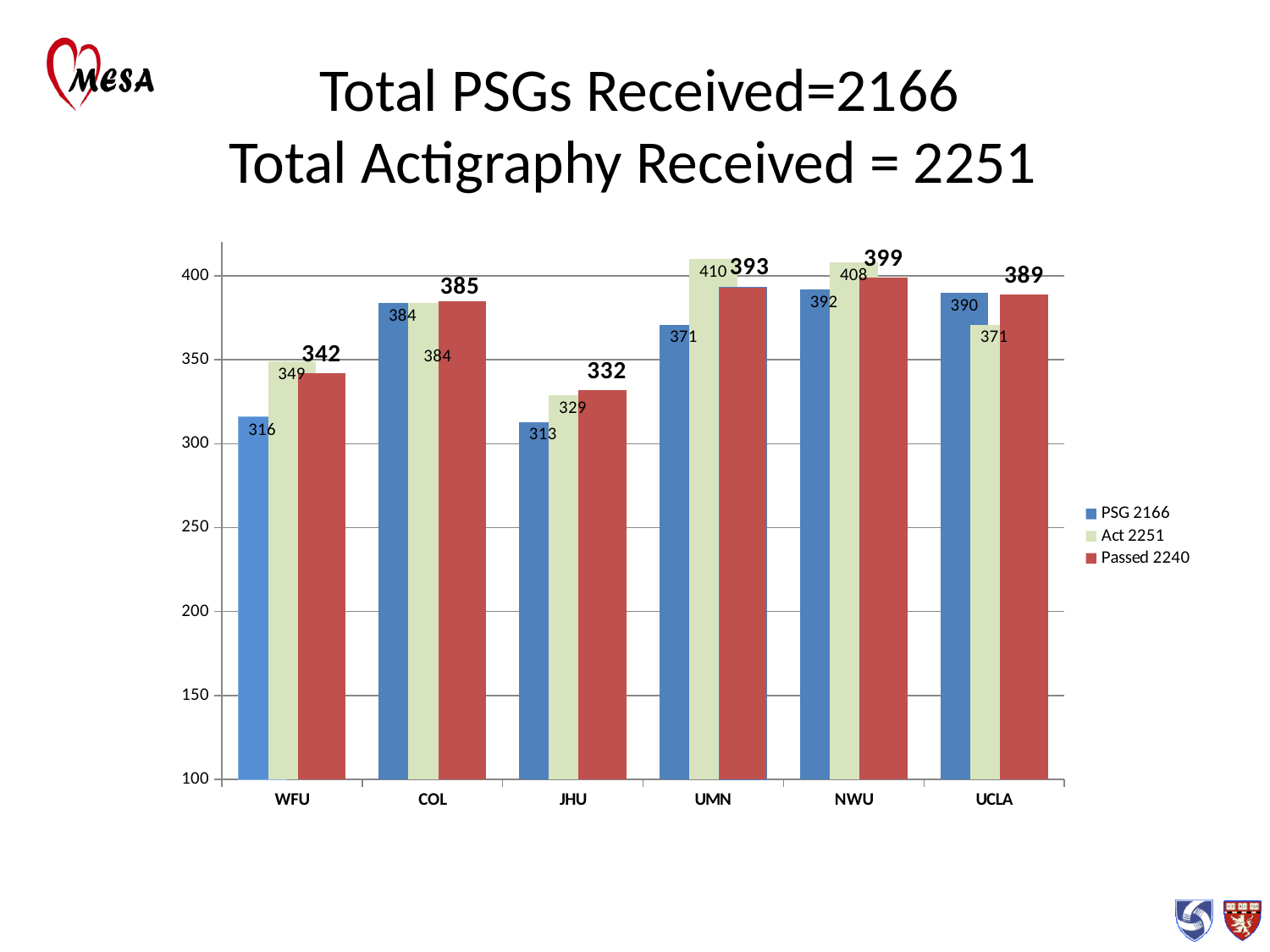
Which site has the highest Passed 2240 value? NWU What is the Passed 2240 value for JHU? 332 What is the Act 2251 value for UCLA? 371 Which is larger for UCLA, the PSG 2166 value or the Act 2251 value? PSG 2166 What is the PSG 2166 value for WFU? 316 What is the Act 2251 value for UMN? 410 How many series does the legend list? 3 Which colour represents the Passed 2240 series? Red How many sites are shown on the x axis? 6 What kind of chart is shown on the slide? Bar chart What is the difference between the Act 2251 value and the PSG 2166 value for UMN? 39 Which site has the lowest PSG 2166 value? JHU